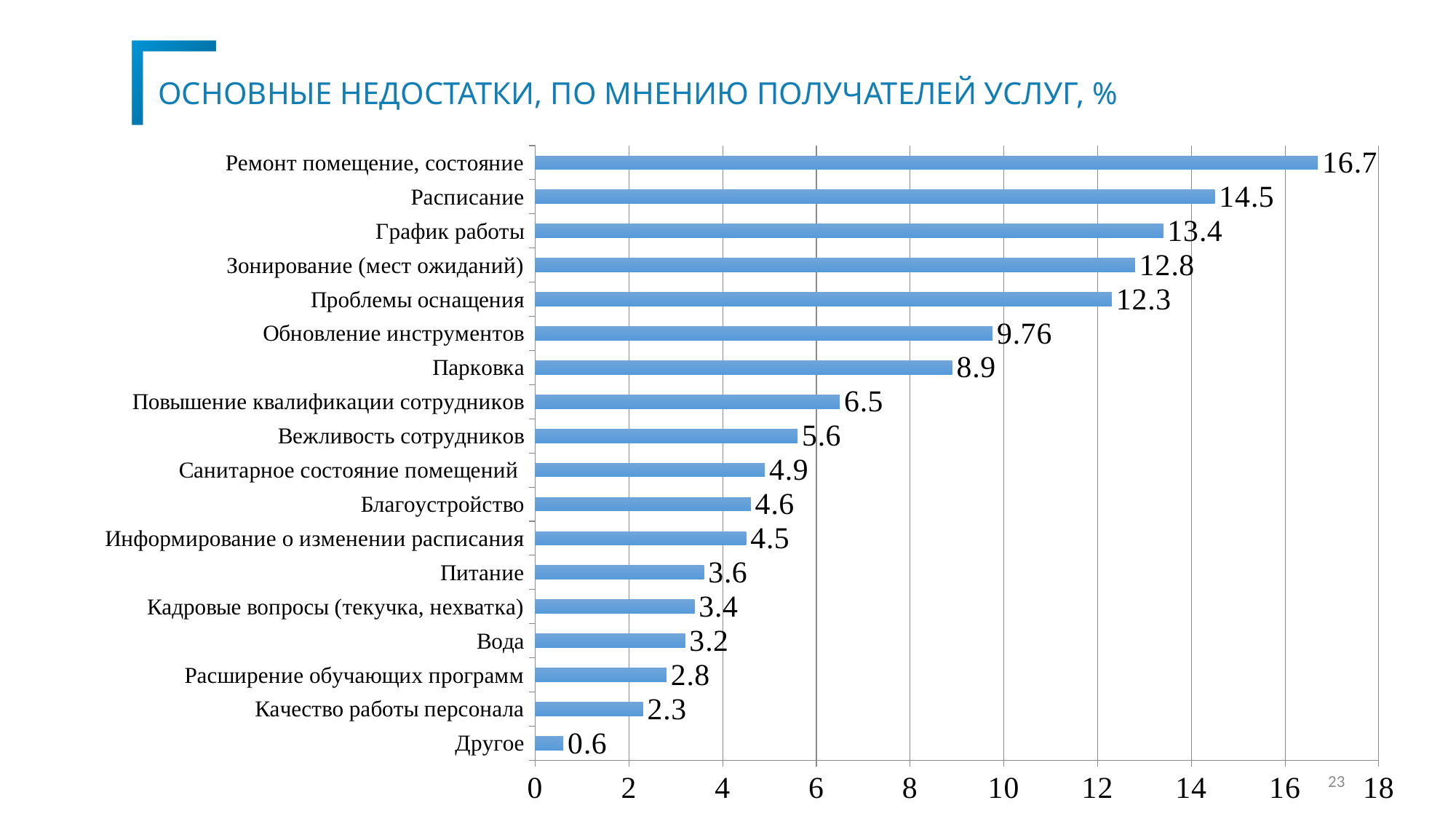
What is the value for Парковка? 8.9 Which category has the highest value? Ремонт помещение, состояние How many categories are shown in the chart? 18 What is the value for Обновление инструментов? 9.76 What kind of chart is shown on the slide? Bar chart Is the value for Зонирование (мест ожиданий) greater or less than 12? greater What is the difference between the values for Расписание and График работы? 1.1 Which is larger, the value for Питание or the value for Благоустройство? Благоустройство Which category has the lowest value? Другое What is the maximum value shown on the horizontal axis? 18 What is the value for Вода? 3.2 What is the title of the chart? ОСНОВНЫЕ НЕДОСТАТКИ, ПО МНЕНИЮ ПОЛУЧАТЕЛЕЙ УСЛУГ, %